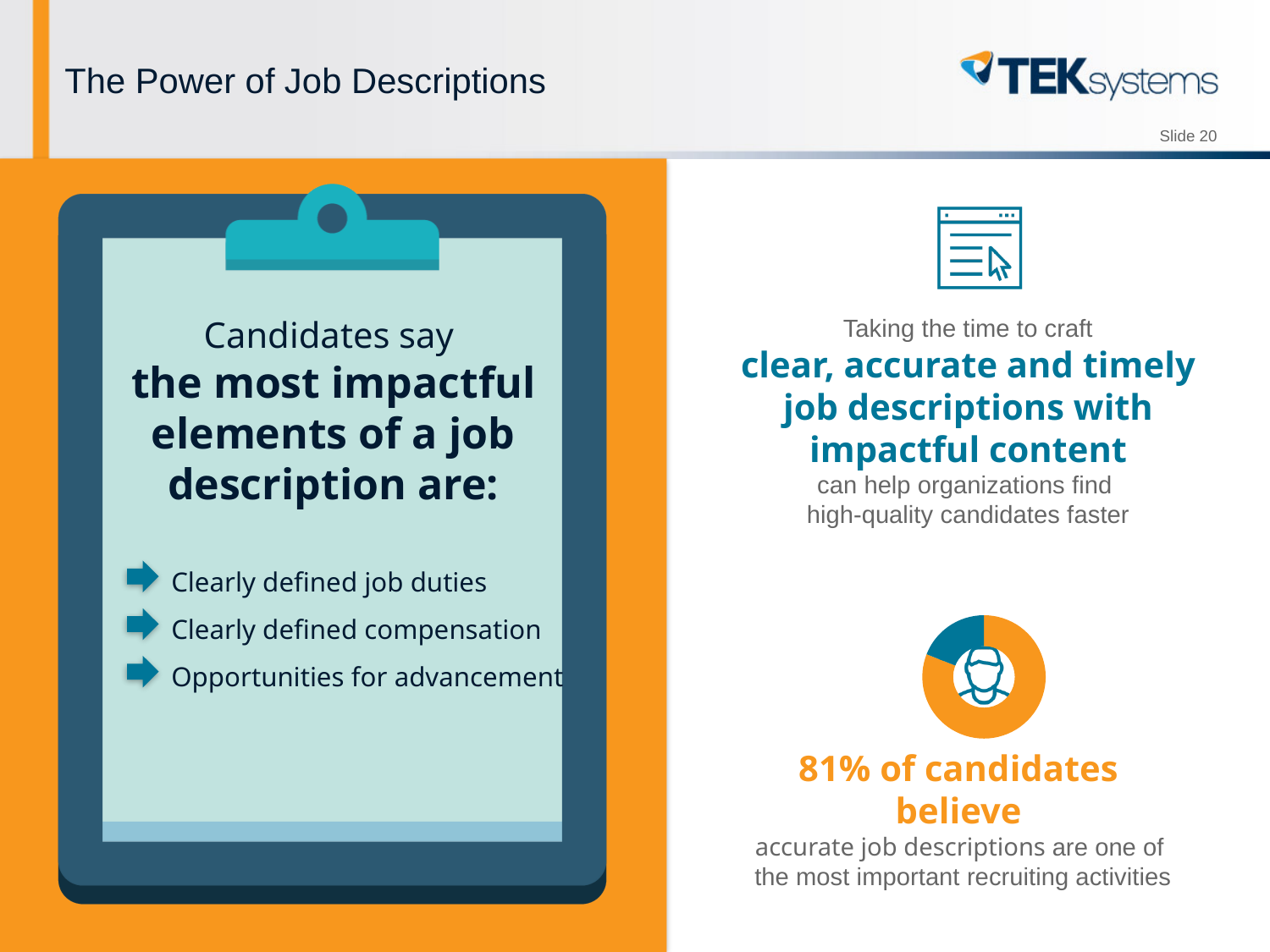
What colour is the segment of the donut chart that represents the 81% of candidates? orange What percentage of candidates believe accurate job descriptions are one of the most important recruiting activities, as shown by the donut chart? 81% How many segments does the donut chart showing the 81% statistic have? 2 Is the share represented by the orange segment of the donut chart greater or less than 50%? greater What kind of chart is used to illustrate the 81% of candidates statistic? pie chart (donut) In the donut chart, which segment is larger, the orange one or the blue one? orange